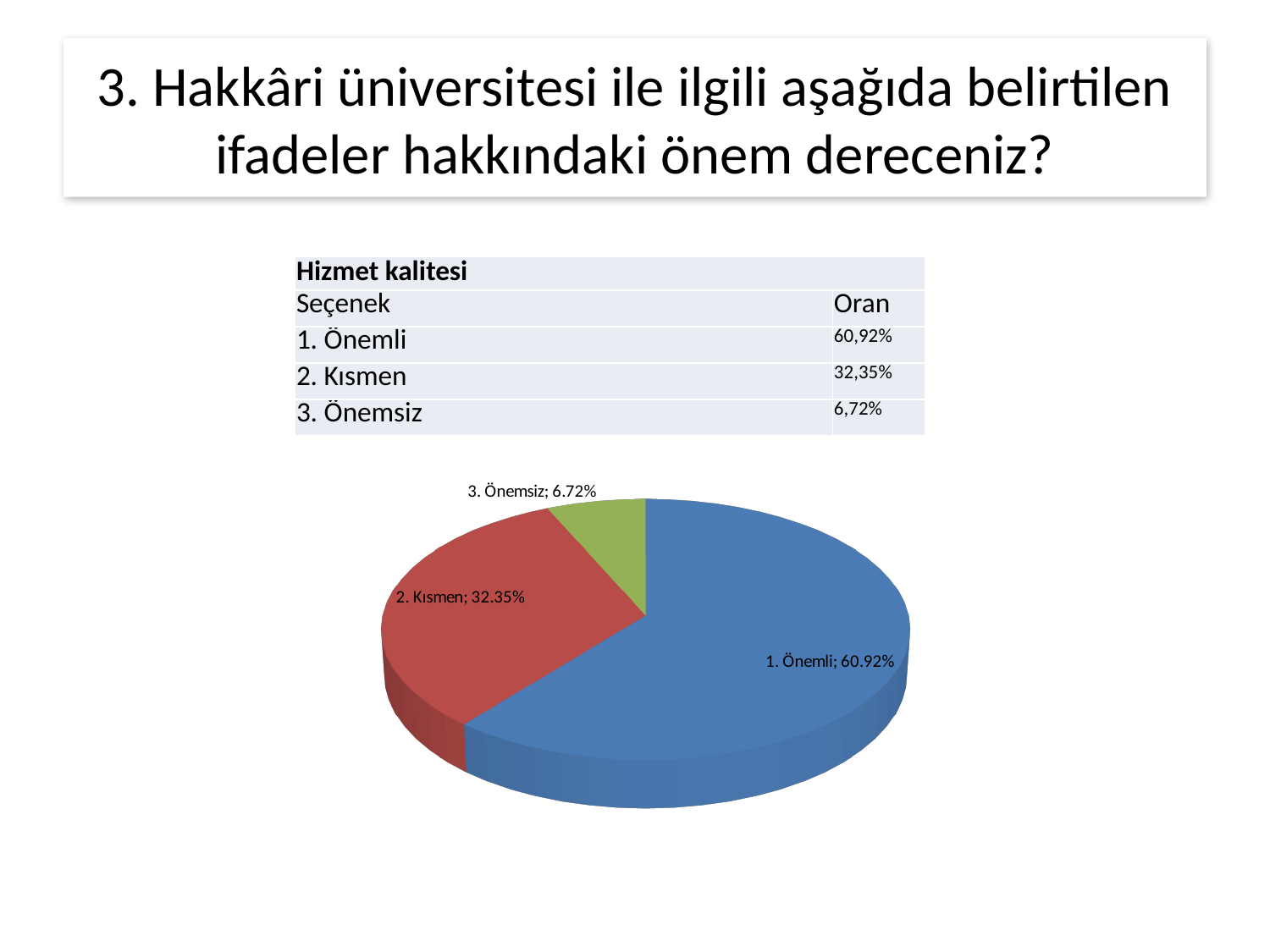
How many slices does the pie chart have? 3 Which slice of the pie chart is the largest? 1. Önemli What colour is the slice for "1. Önemli" in the pie chart? blue What is the value shown for the slice labelled "1. Önemli"? 60.92% Which slice of the pie chart is the smallest? 3. Önemsiz What colour is the slice for "2. Kısmen" in the pie chart? red What is the value shown for the slice labelled "3. Önemsiz"? 6.72% What is the value shown for the slice labelled "2. Kısmen"? 32.35% What is the difference in percentage points between the "2. Kısmen" slice and the "3. Önemsiz" slice? 25.63 Which is larger, the slice for "2. Kısmen" or the slice for "3. Önemsiz"? 2. Kısmen What type of chart is shown on the slide? pie chart What is the difference in percentage points between the "1. Önemli" slice and the "2. Kısmen" slice? 28.57